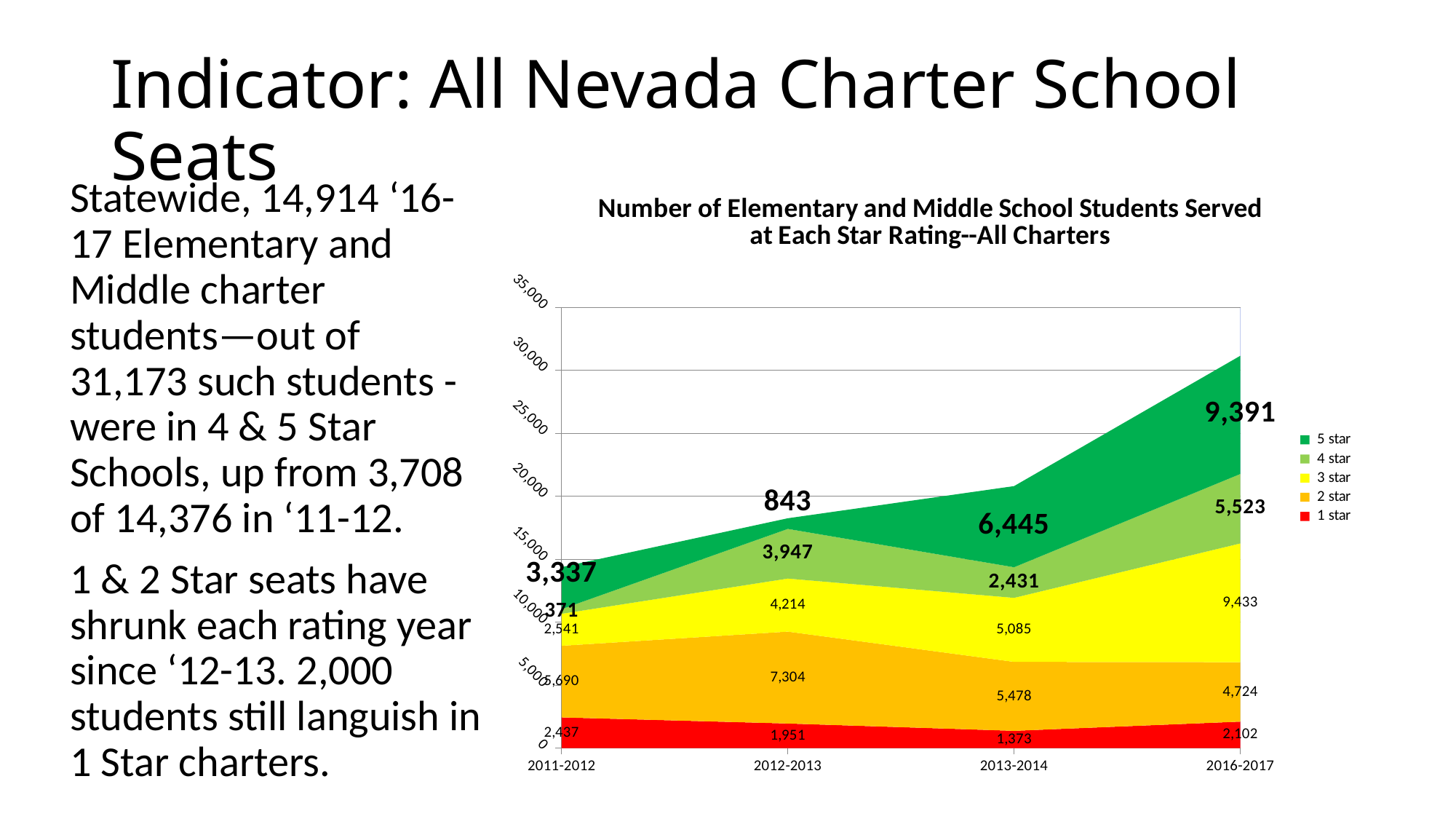
How many school-year categories are shown on the x axis? 4 What is the number of students in 5 star charters in 2016-2017? 9,391 What kind of chart is shown on the slide? Stacked area chart What is the number of students in 4 star charters in 2011-2012? 371 What is the difference between the 4 star values in 2016-2017 and 2013-2014? 3,092 What is the total number of students across all star ratings in 2016-2017? 31,173 Which is larger in 2012-2013: the 2 star value or the 4 star value? 2 star In which school year is the 5 star value the lowest? 2012-2013 What is the number of students in 3 star charters in 2012-2013? 4,214 In which school year is the 3 star value the highest? 2016-2017 How many series does the legend list? 5 What is the number of students in 1 star charters in 2013-2014? 1,373